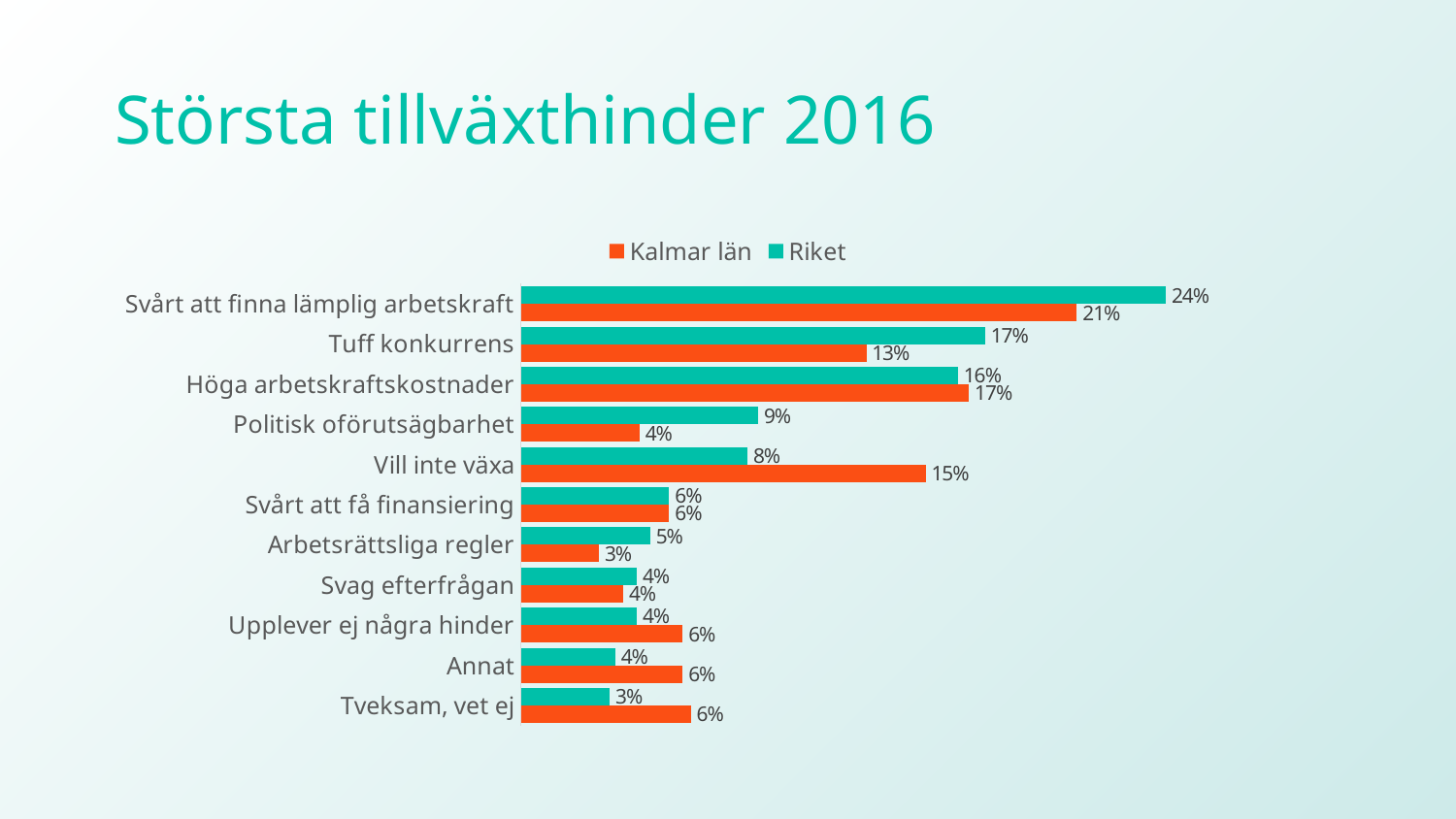
How many series does the legend list? 2 What is the Riket value for Politisk oförutsägbarhet? 9% For Höga arbetskraftskostnader, which is larger: the Kalmar län value or the Riket value? Kalmar län What is the Kalmar län value for Tuff konkurrens? 13% Which category has the lowest Riket value? Tveksam, vet ej How many categories are shown in the chart? 11 What is the Riket value for Svårt att finna lämplig arbetskraft? 24% What kind of chart is shown on the slide? Bar chart What is the Kalmar län value for Vill inte växa? 15% What is the title of the slide? Största tillväxthinder 2016 What is the difference between the Riket and Kalmar län values for Vill inte växa? 7% Which category has the highest Kalmar län value? Svårt att finna lämplig arbetskraft